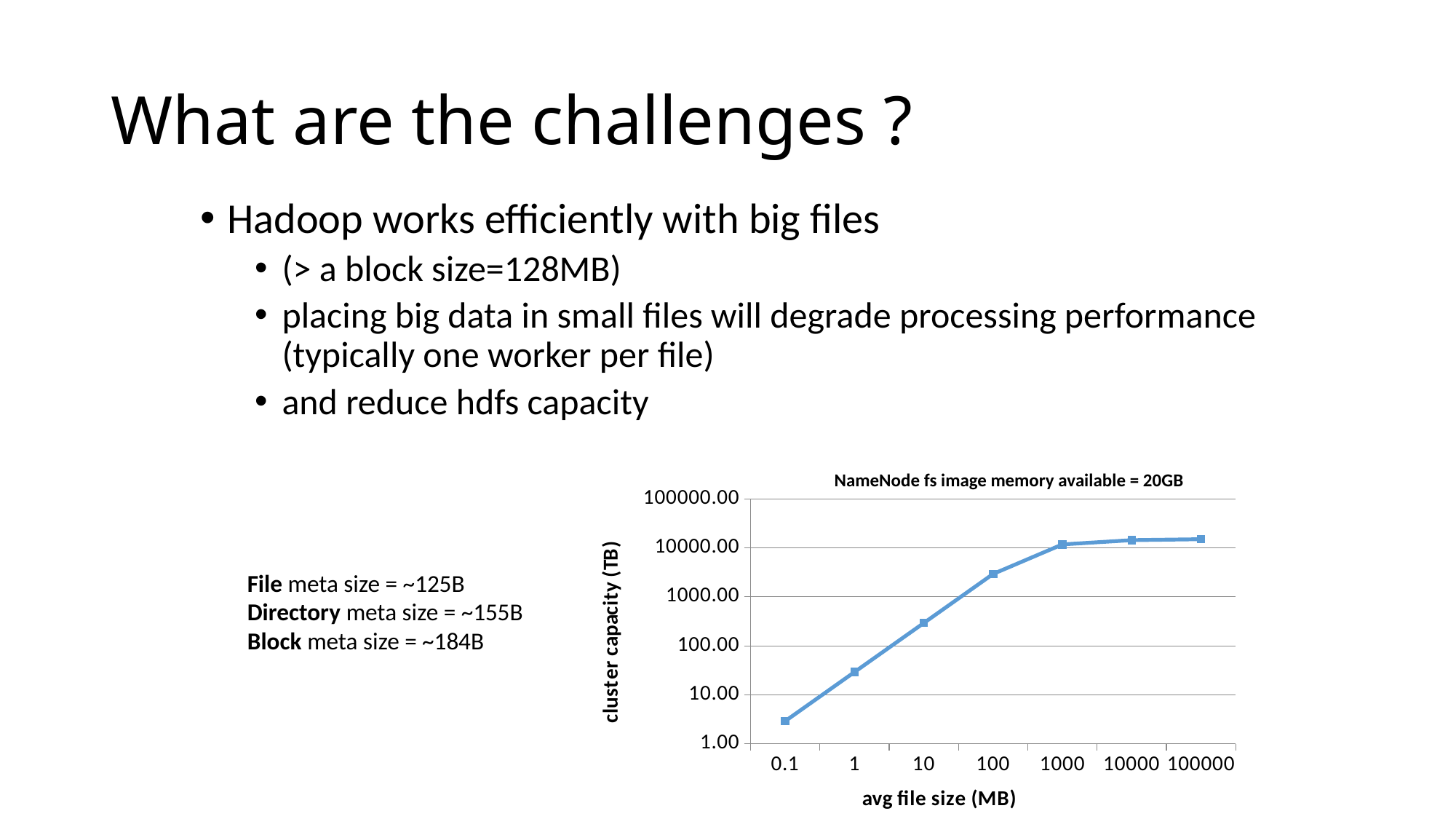
Which avg file size has the lowest cluster capacity? 0.1 What kind of chart is shown on the slide? line chart Which avg file size has the highest cluster capacity? 100000 Is the cluster capacity for an avg file size of 10 MB greater or less than 1000.00? less Is the cluster capacity for an avg file size of 0.1 MB greater or less than 10.00? less Which has a larger cluster capacity: an avg file size of 1 MB or 100 MB? 100 MB Is the cluster capacity for an avg file size of 1 MB greater or less than 10.00? greater What is the label of the y axis of the chart? cluster capacity (TB) How many data points are plotted on the line? 7 What is the title of the chart? NameNode fs image memory available = 20GB Does the cluster capacity rise or fall as the avg file size increases along the x axis? rise